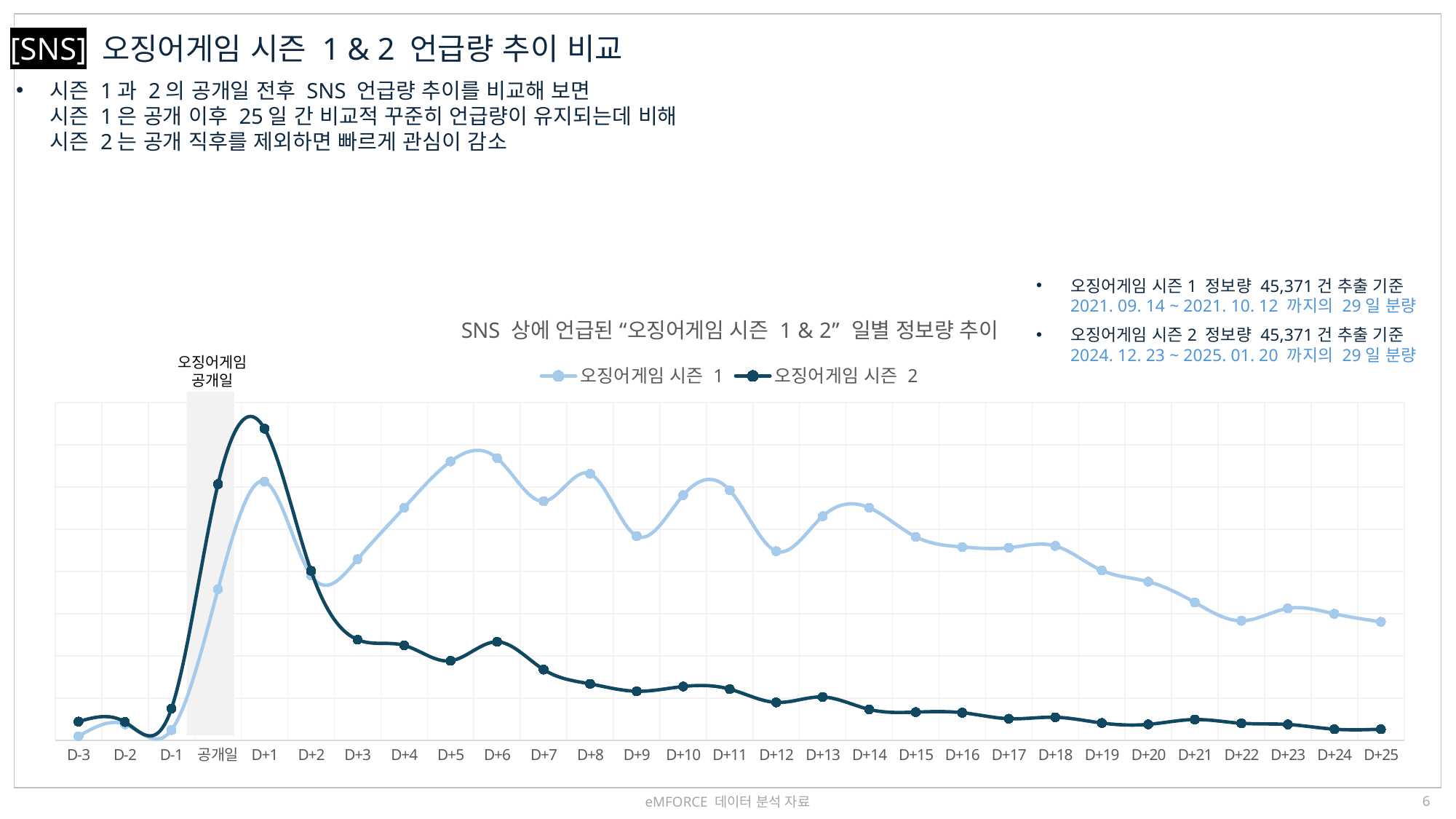
On which day does the 오징어게임 시즌 2 series reach its highest value? D+1 At D+10, which series has the larger value, 오징어게임 시즌 1 or 오징어게임 시즌 2? 오징어게임 시즌 1 At D+1, which series has the larger value, 오징어게임 시즌 1 or 오징어게임 시즌 2? 오징어게임 시즌 2 For 오징어게임 시즌 1, which day has the larger value, D+1 or D+25? D+1 Does the 오징어게임 시즌 1 series rise or fall from D+2 to D+6? rise How many points (days) are plotted along the x axis, from D-3 to D+25? 29 Does the 오징어게임 시즌 2 series rise or fall from D+1 to D+25? fall Which x-axis category is highlighted with a shaded band labelled 오징어게임 공개일? 공개일 What kind of chart is shown on the slide? line chart What is the title of the chart? SNS 상에 언급된 “오징어게임 시즌 1 & 2” 일별 정보량 추이 How many series does the chart legend list? 2 On which day is the 오징어게임 시즌 1 series at its lowest value? D-3